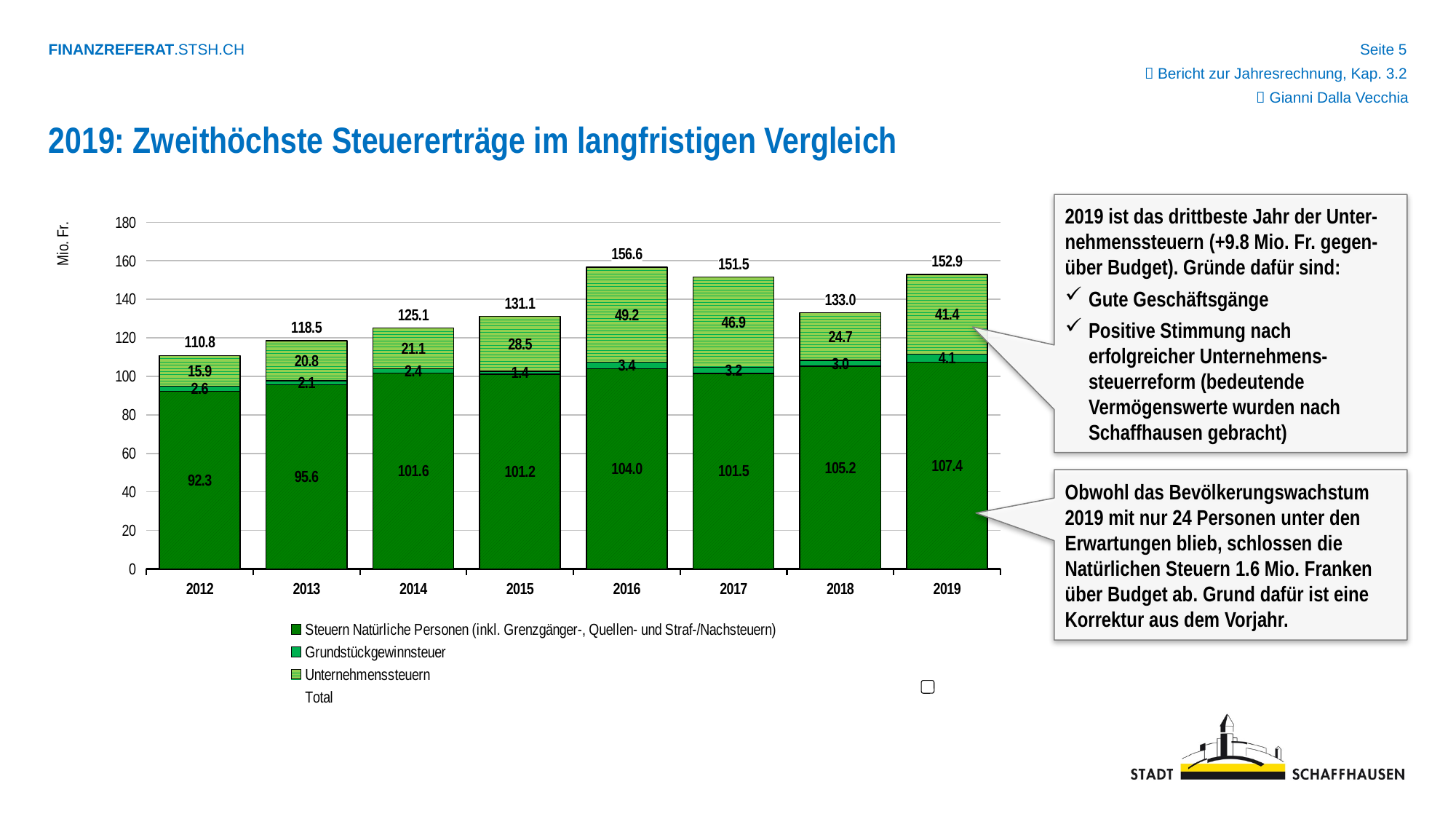
Which year has the lowest value for Grundstückgewinnsteuer? 2015 What is the value of Steuern Natürliche Personen in 2012? 92.3 What unit is given on the y axis of the chart? Mio. Fr. What is the value of Unternehmenssteuern in 2016? 49.2 Which is larger, the total for 2017 or the total for 2019? 2019 What is the difference between the Unternehmenssteuern values for 2016 and 2019? 7.8 What is the value of Grundstückgewinnsteuer in 2019? 4.1 What is the total tax revenue shown for 2019? 152.9 Which year has the highest total tax revenue? 2016 How many entries does the legend list? 4 How many years are shown on the x axis? 8 What kind of chart is shown on the slide? Stacked bar chart